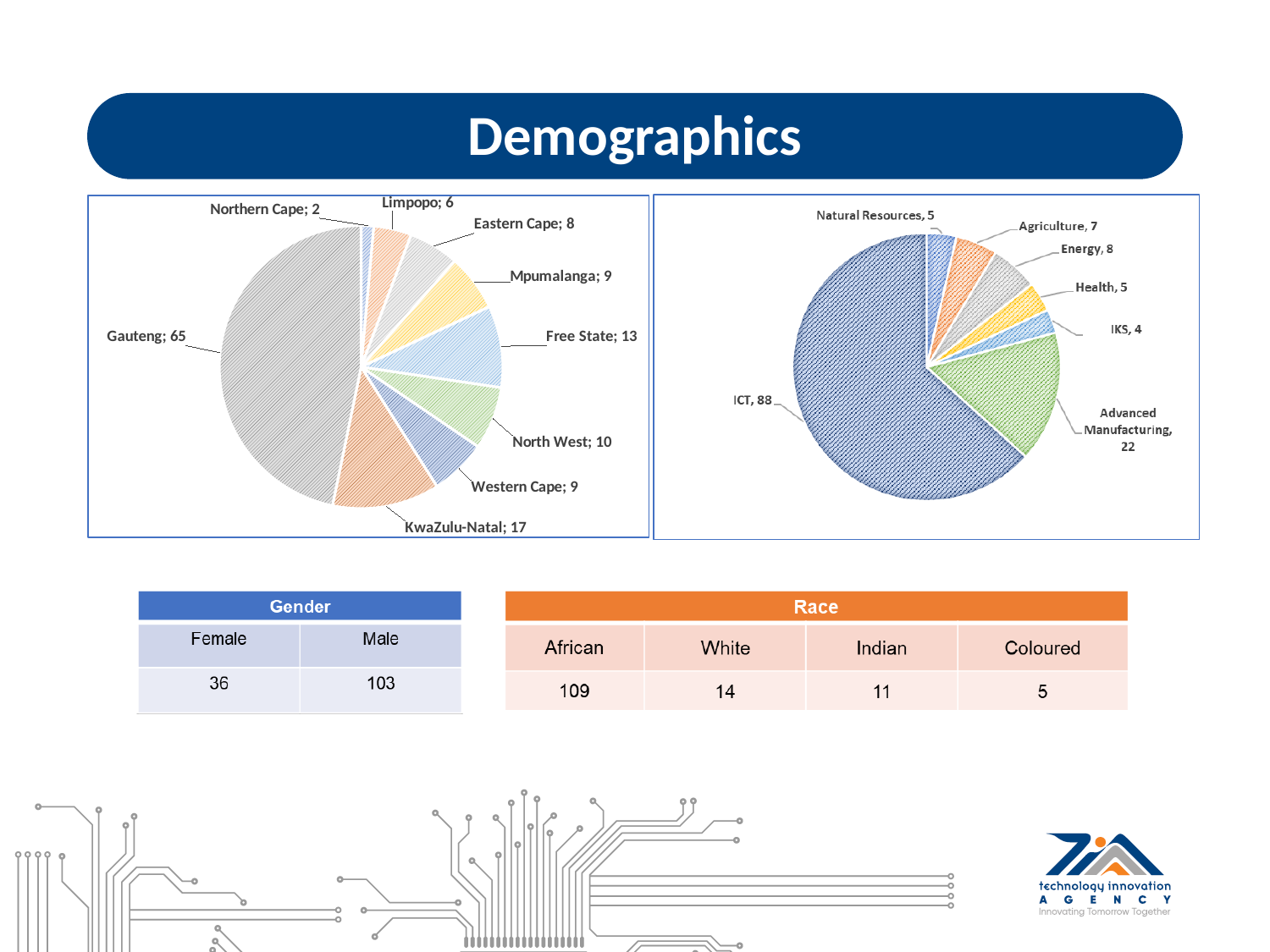
In the right-hand pie chart, which is larger, Energy or Agriculture? Energy In the right-hand pie chart, what is the value for Advanced Manufacturing? 22 In the left-hand pie chart, what is the value for Gauteng? 65 How many provinces are shown in the left-hand pie chart? 9 How many sectors are shown in the right-hand pie chart? 7 In the left-hand pie chart, what is the value for KwaZulu-Natal? 17 In the left-hand pie chart, which province has the smallest slice? Northern Cape In the left-hand pie chart, what is the difference between the values for Free State and North West? 3 In the right-hand pie chart, which sector has the largest slice? ICT In the left-hand pie chart, which province has the largest slice? Gauteng What kind of chart is the left-hand chart on the slide? Pie chart In the right-hand pie chart, which sector has the smallest slice? IKS